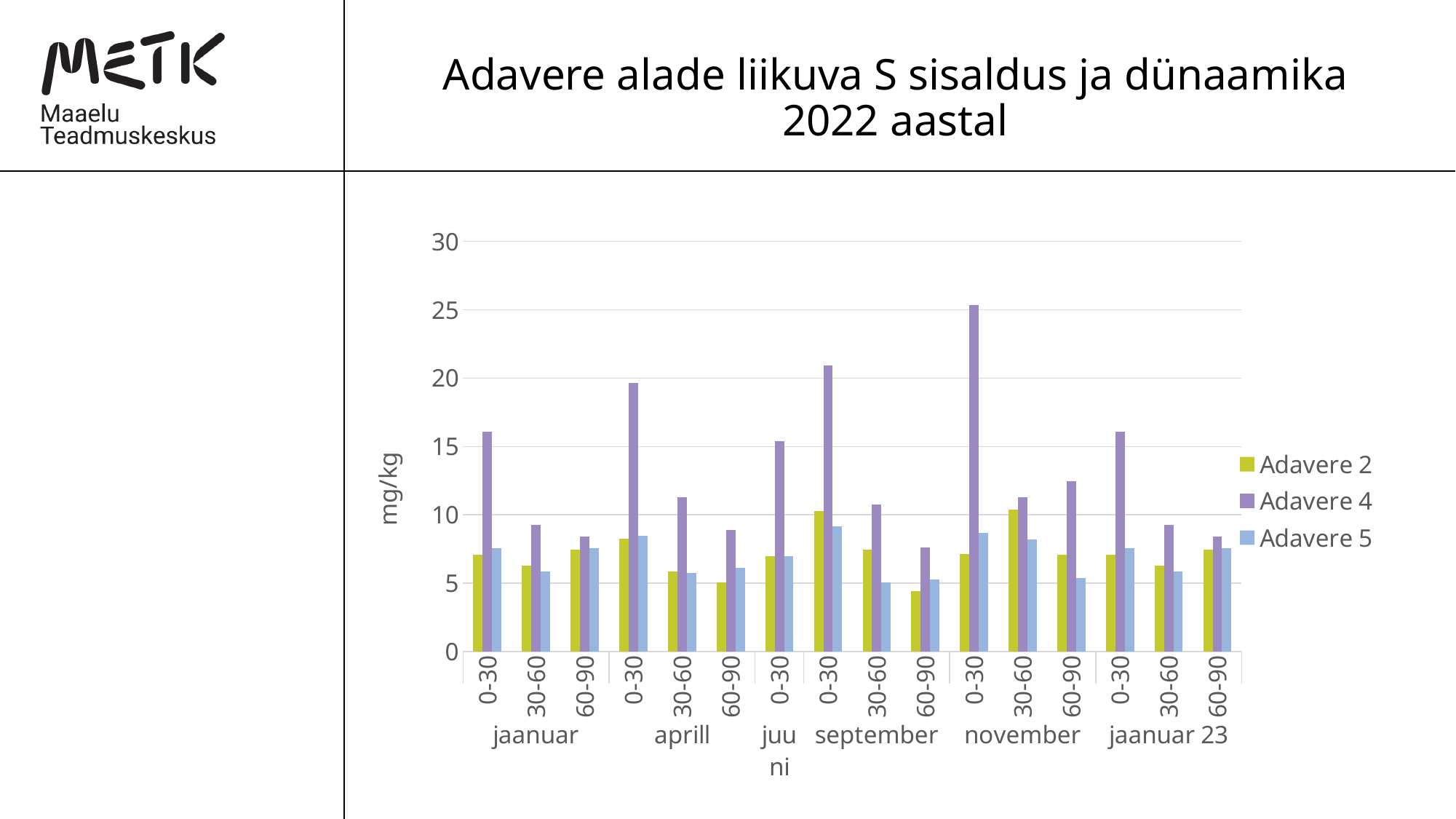
Which series has the highest bar in the chart? Adavere 4 At september 0-30, which is larger: Adavere 2 or Adavere 5? Adavere 2 How many series does the legend list? 3 How many month labels are shown along the x axis? 6 Is the value for Adavere 4 at aprill 0-30 greater or less than 15? greater Is the value for Adavere 4 at november 0-30 greater or less than 20? greater What is the label on the y axis? mg/kg Is the value for Adavere 2 at september 60-90 greater or less than 5? less Which is larger for Adavere 4: the value at november 0-30 or at september 0-30? november 0-30 What kind of chart is shown on the slide? bar chart In which month and depth does Adavere 4 reach its highest value? november, 0-30